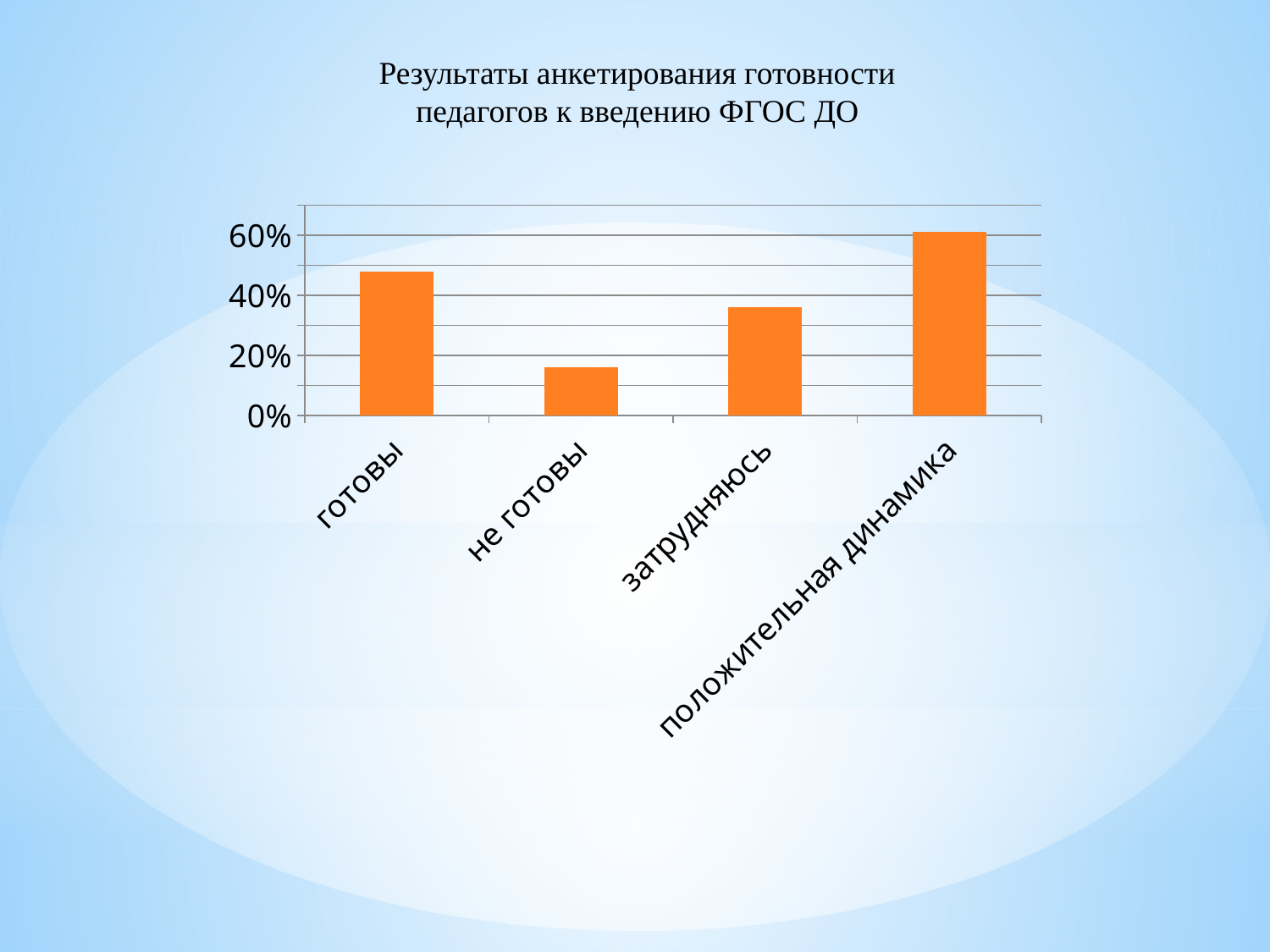
What is the title of the slide above the chart? Результаты анкетирования готовности педагогов к введению ФГОС ДО Which category has the lowest bar? не готовы How many categories are shown on the x axis of the chart? 4 Which category has the highest bar? положительная динамика Which is larger, the value for готовы or the value for затрудняюсь? готовы Is the value for затрудняюсь greater or less than 40%? less Is the value for положительная динамика greater or less than 40%? greater Is the value for готовы greater or less than 40%? greater What kind of chart is shown on the slide? bar chart What colour are the bars in the chart? orange Which is larger, the value for не готовы or the value for затрудняюсь? затрудняюсь